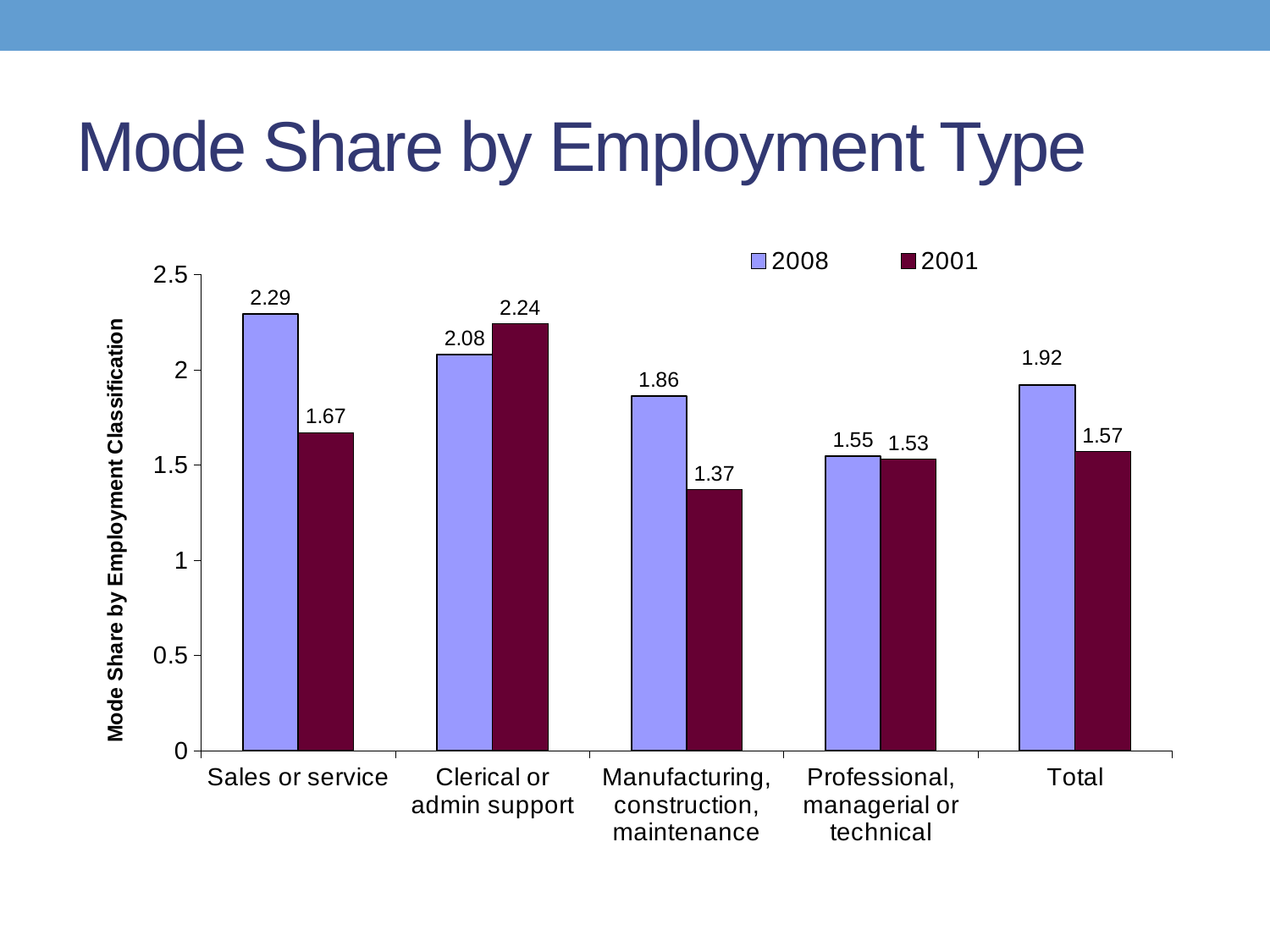
Is the 2008 value for Total greater or less than 1.5? greater What is the 2001 value for Manufacturing, construction, maintenance? 1.37 What is the difference between the 2008 and 2001 values for Sales or service? 0.62 How many series does the legend list? 2 Which category has the highest 2008 value? Sales or service Which category has the lowest 2001 value? Manufacturing, construction, maintenance What is the label of the vertical axis? Mode Share by Employment Classification What is the 2001 value for Total? 1.57 How many categories are shown on the x axis? 5 What kind of chart is shown on the slide? bar chart What is the 2008 value for Sales or service? 2.29 Which is larger for Clerical or admin support, the 2008 value or the 2001 value? 2001